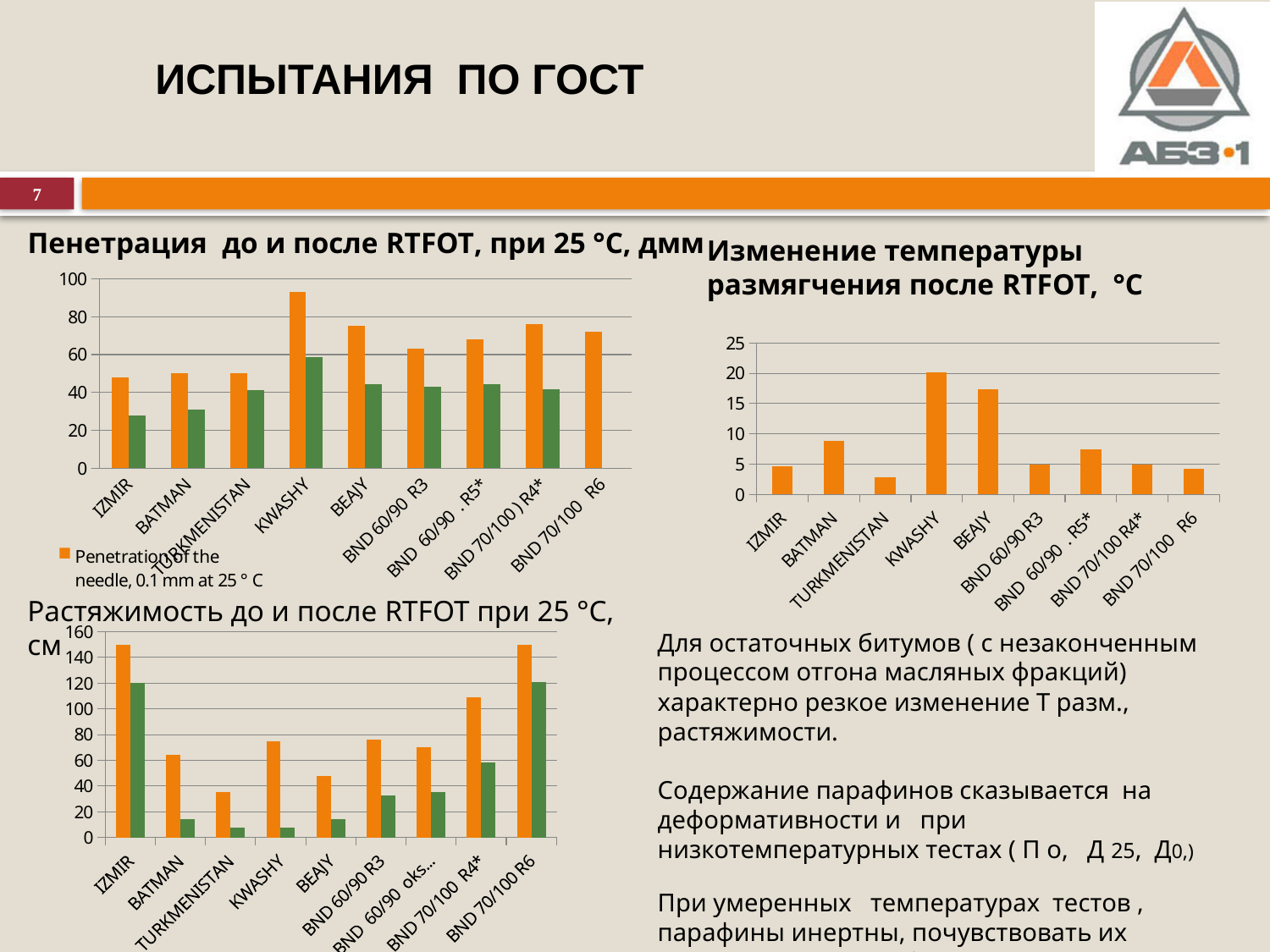
In the chart titled 'Растяжимость до и после RTFOT при 25 °C, см', is the orange bar for TURKMENISTAN greater or less than 40? less How many categories are shown on the x axis of the chart titled 'Изменение температуры размягчения после RTFOT, °C'? 9 In the chart titled 'Пенетрация до и после RTFOT, при 25 °C, дмм', is the green bar for IZMIR greater or less than 40? less In the chart titled 'Пенетрация до и после RTFOT, при 25 °C, дмм', is the orange bar for KWASHY greater or less than 80? greater In the chart titled 'Изменение температуры размягчения после RTFOT, °C', which category has the lowest value? TURKMENISTAN What type of chart is the one titled 'Растяжимость до и после RTFOT при 25 °C, см'? bar chart In the chart titled 'Изменение температуры размягчения после RTFOT, °C', which is larger, the value for BATMAN or the value for BND 60/90 R3? BATMAN In the chart titled 'Изменение температуры размягчения после RTFOT, °C', which category has the highest value? KWASHY In the chart titled 'Пенетрация до и после RTFOT, при 25 °C, дмм', which category has the tallest orange bar? KWASHY In the chart titled 'Растяжимость до и после RTFOT при 25 °C, см', which is larger, the orange bar for BND 60/90 R3 or the orange bar for BEAJY? BND 60/90 R3